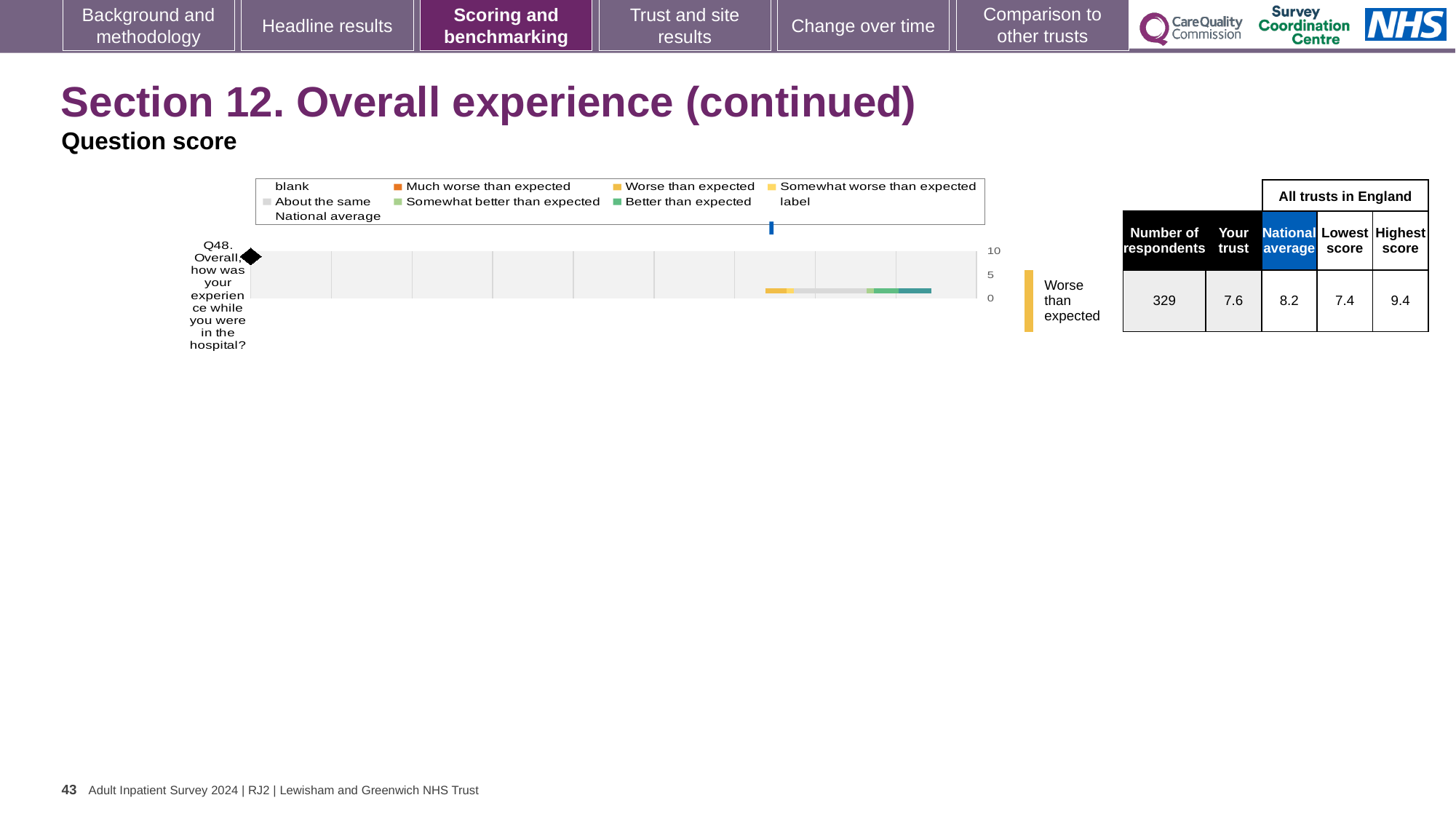
In the table next to the chart, what is the Highest score among all trusts in England for Q48? 9.4 In the table next to the chart, what is the National average score for Q48? 8.2 Which is larger for Q48, the Your trust score or the National average score? National average What is the highest value shown on the chart's axis? 10 What kind of chart is shown on the slide for Q48? bar chart What benchmark rating is shown beside the chart for Q48? Worse than expected In the table next to the chart, what is the score for Your trust on Q48? 7.6 In the table next to the chart, what is the Lowest score among all trusts in England for Q48? 7.4 Which question is plotted in the chart? Q48. Overall, how was your experience while you were in the hospital? In the table next to the chart, what is the number of respondents for Q48? 329 How many question categories are plotted in the chart? 1 What is the difference between the National average score and the Your trust score for Q48? 0.6